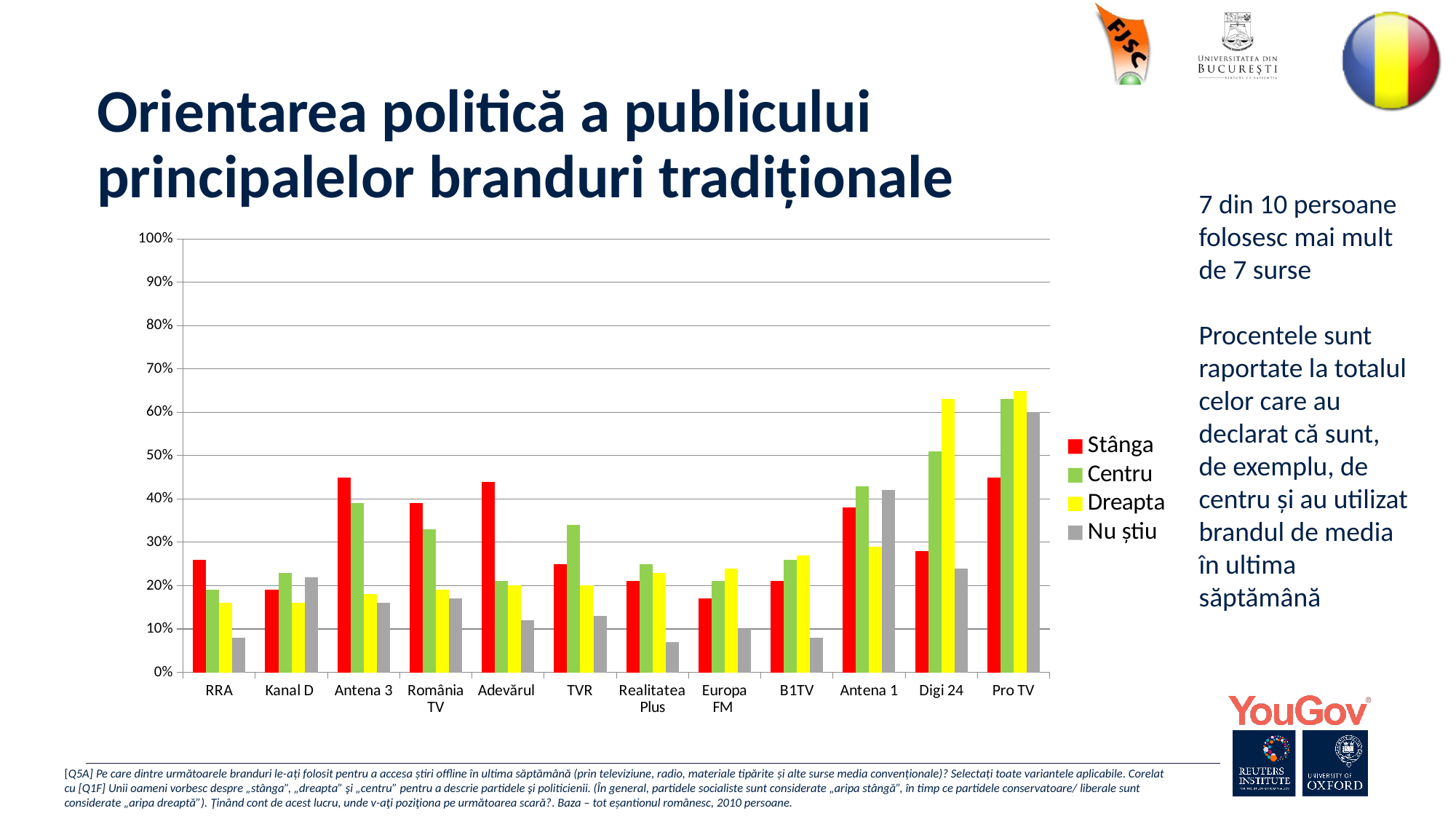
Is the Dreapta value for Pro TV greater or less than 60%? greater Is the Stânga value for Europa FM greater or less than 20%? less Is the Stânga value for Antena 3 greater or less than 40%? greater Which brand has the highest Nu știu value? Pro TV Which series is shown in yellow in the chart? Dreapta For Antena 3, which is larger: the Stânga value or the Dreapta value? Stânga For Digi 24, which is larger: the Stânga value or the Dreapta value? Dreapta How many series does the chart legend list? 4 How many media brands are shown on the x axis of the chart? 12 What kind of chart is shown on the slide? bar chart